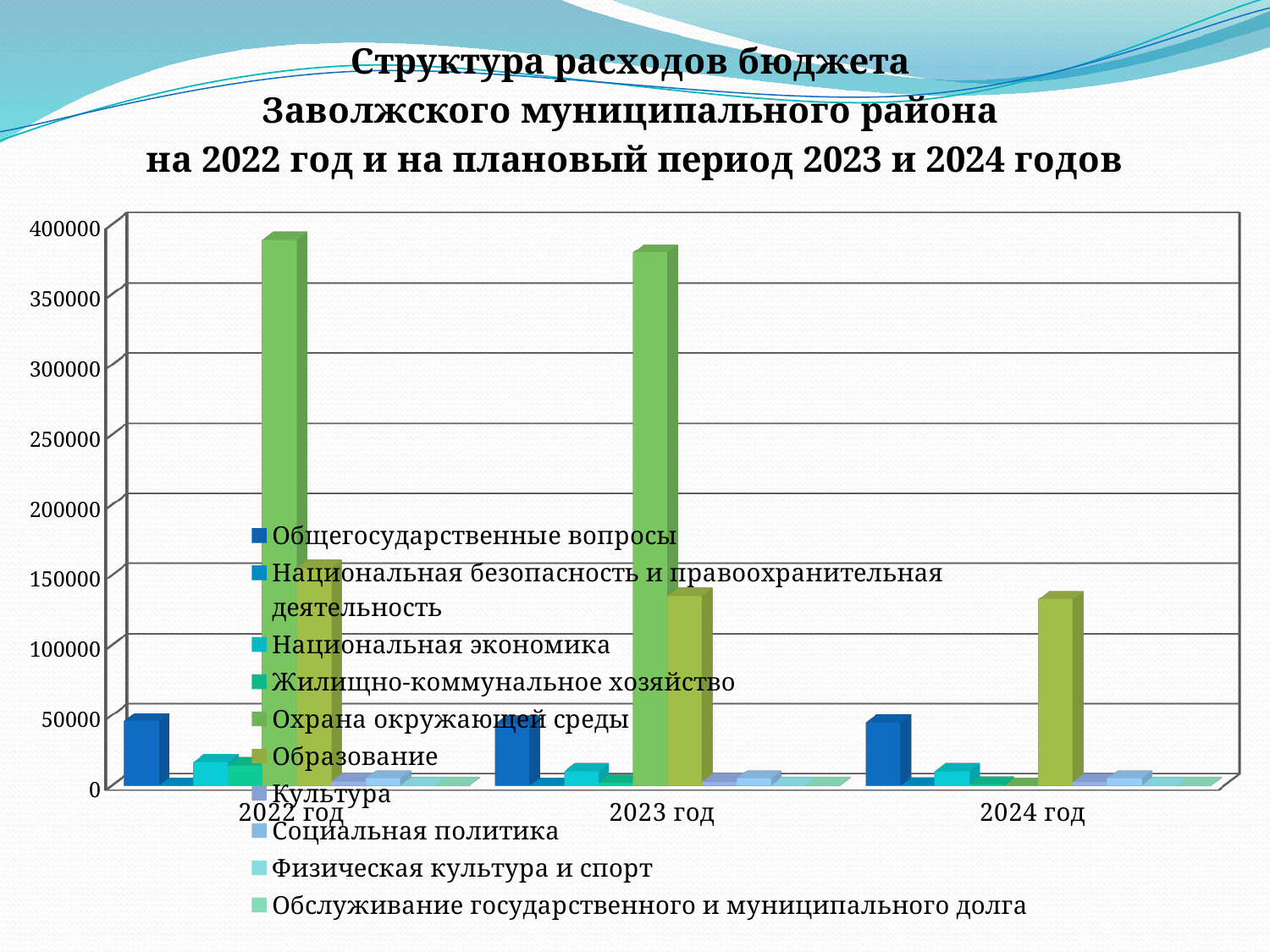
Is the tallest bar for 2024 год greater or less than 150000? less What is the first entry in the chart's legend? Общегосударственные вопросы Is the value for Общегосударственные вопросы in 2024 год greater or less than 100000? less Is the value for Общегосударственные вопросы in 2023 год greater or less than 100000? less Which year has the lowest tallest bar: 2022 год, 2023 год or 2024 год? 2024 год How many year categories are shown on the x axis of the chart? 3 How many series does the chart's legend list? 10 What is the last entry in the chart's legend? Обслуживание государственного и муниципального долга What kind of chart is shown on the slide? bar chart Which is larger: the tallest bar for 2022 год or the tallest bar for 2024 год? 2022 год